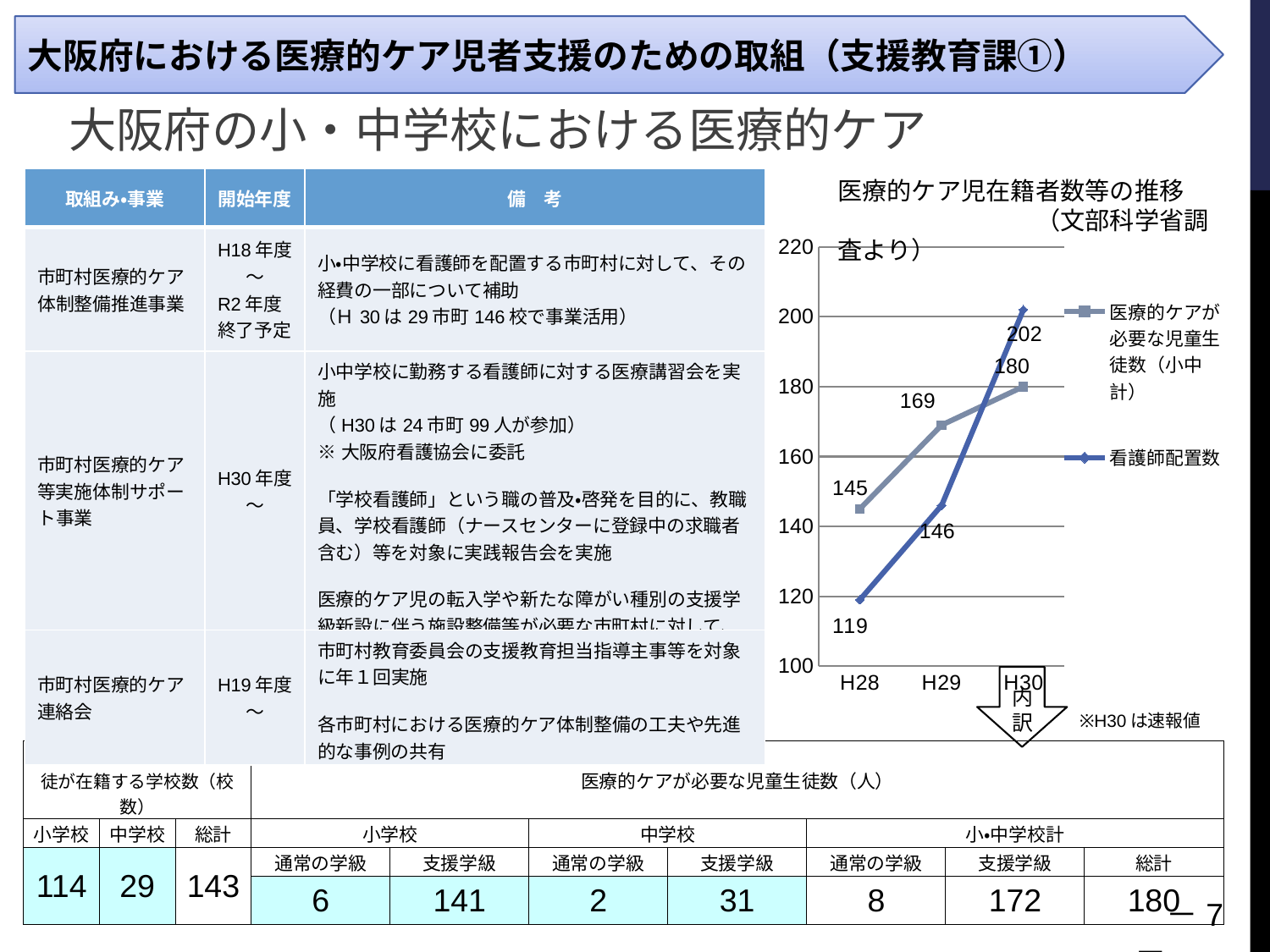
What is the value of 看護師配置数 for H30? 202 Does 看護師配置数 rise or fall from H28 to H30? rise In which year is 看護師配置数 lowest? H28 What is the value of 医療的ケアが必要な児童生徒数（小中計） for H28? 145 Which is larger in H29: 医療的ケアが必要な児童生徒数（小中計） or 看護師配置数? 医療的ケアが必要な児童生徒数（小中計） What is the difference between 看護師配置数 and 医療的ケアが必要な児童生徒数（小中計） in H30? 22 How many series does the chart legend list? 2 What is the value of 医療的ケアが必要な児童生徒数（小中計） for H30? 180 How many points along the x axis does the chart show? 3 What is the value of 看護師配置数 for H29? 146 What type of chart is shown on the slide? line chart What is the title of the chart? 医療的ケア児在籍者数等の推移（文部科学省調査より）